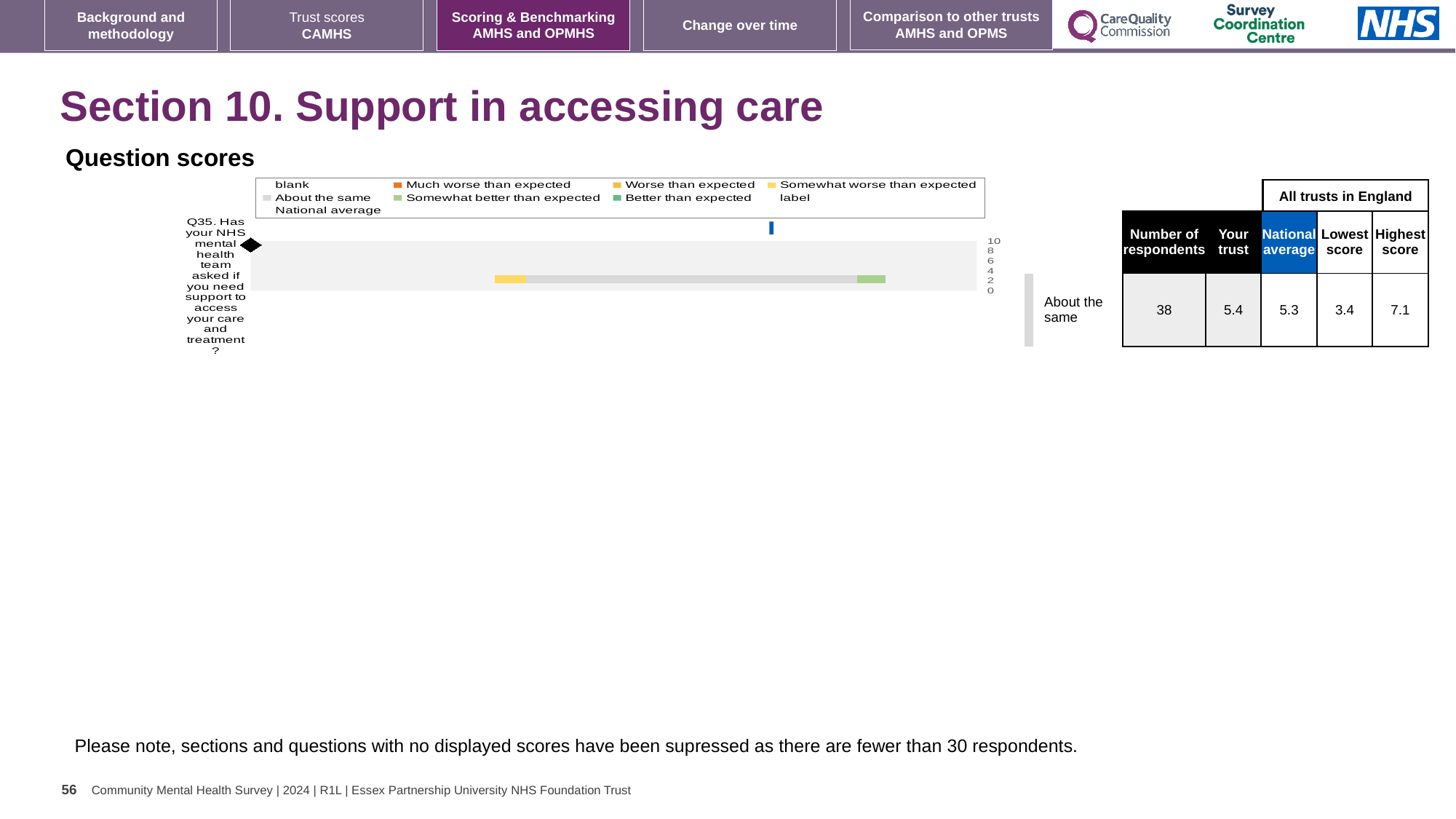
Which question number is plotted in the Question scores chart? Q35 What is the highest tick value shown on the axis of the Question scores chart? 10 In the table beside the chart, what is the number of respondents for Q35? 38 What kind of chart is shown under 'Question scores'? bar chart In the table beside the chart, what is the 'Your trust' score for Q35? 5.4 In the table beside the chart, what is the Highest score among all trusts in England for Q35? 7.1 For Q35, what is the difference between the Highest score and the Lowest score among all trusts in England? 3.7 In the table beside the chart, what is the National average score for Q35? 5.3 In the table beside the chart, what is the Lowest score among all trusts in England for Q35? 3.4 For Q35, which is larger: the 'Your trust' score or the National average score? Your trust How many questions are plotted in the Question scores chart? 1 How many entries does the legend of the Question scores chart list? 9